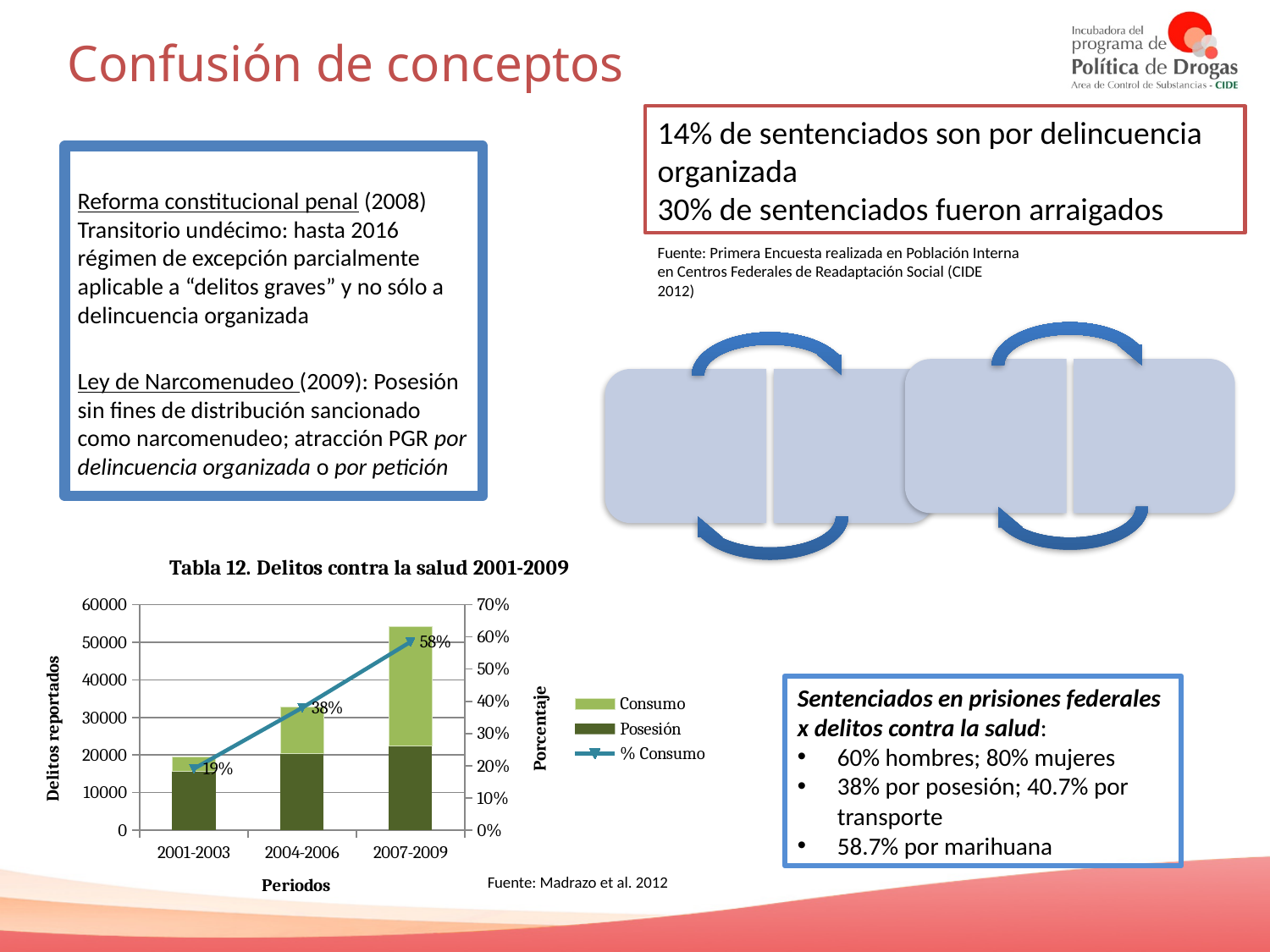
In the 'Tabla 12' chart, is the total height of the stacked bar for 2007-2009 greater or less than 50000? greater In the 'Tabla 12' chart, what is the % Consumo value for 2007-2009? 58% In the 'Tabla 12' chart, which period has the highest % Consumo? 2007-2009 In the 'Tabla 12' chart, what is the difference between the % Consumo for 2007-2009 and for 2001-2003? 39% In the 'Tabla 12' chart, what is the % Consumo value for 2004-2006? 38% In the 'Tabla 12' chart, is the total height of the stacked bar for 2004-2006 greater or less than 30000? greater How many periods are shown on the x axis of the 'Tabla 12' chart? 3 In the 'Tabla 12' chart, does the % Consumo line rise or fall from 2001-2003 to 2007-2009? rise In the 'Tabla 12' chart, what is the % Consumo value for 2001-2003? 19% How many series does the legend of the 'Tabla 12' chart list? 3 What kind of chart is shown under the title 'Tabla 12. Delitos contra la salud 2001-2009'? combination bar and line chart In the 'Tabla 12' chart, which period has the lowest % Consumo? 2001-2003